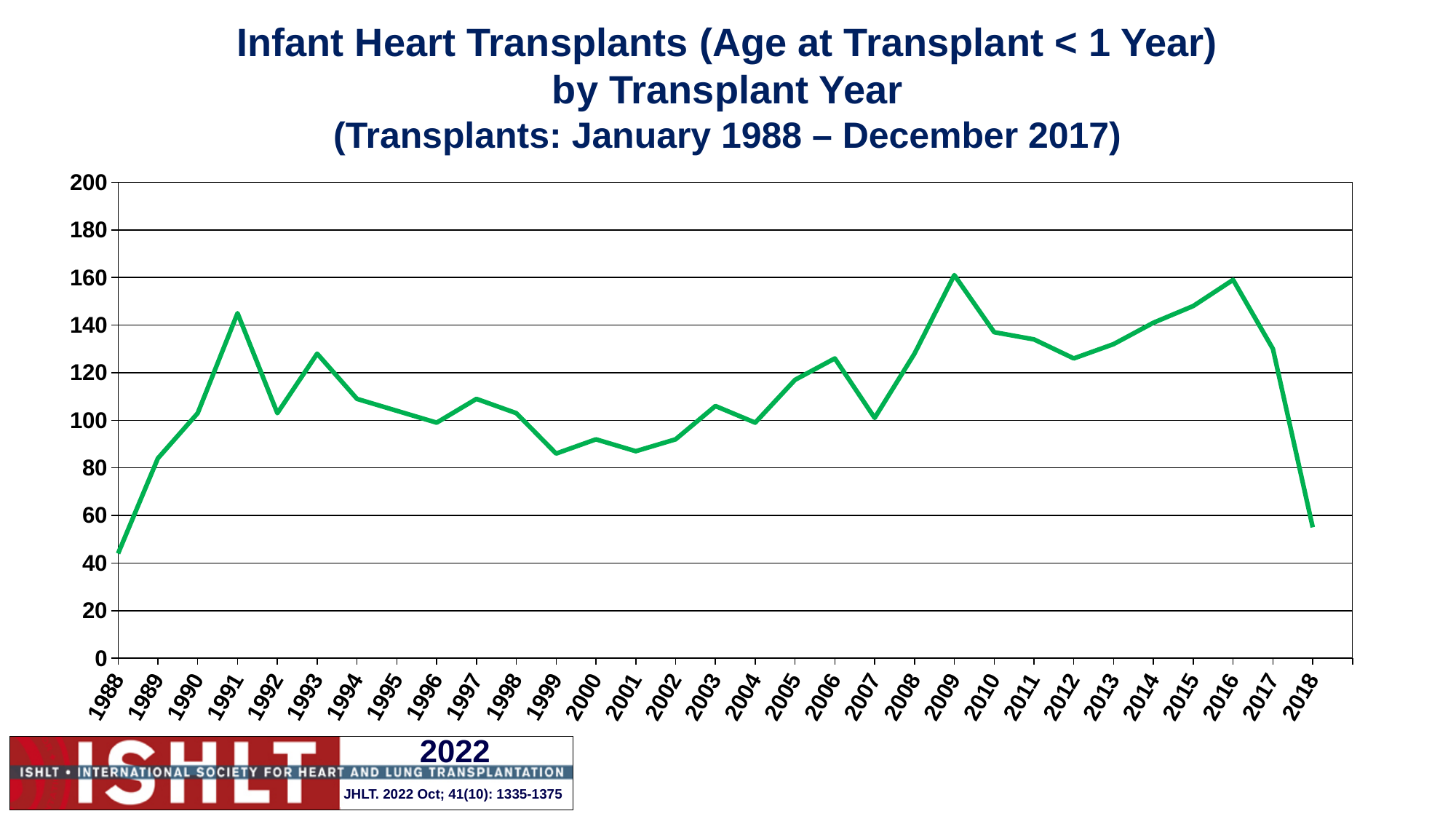
Is the value for 2007 greater or less than 120? less What kind of chart is shown on the slide? line chart What colour is the plotted line? green How many transplant years are plotted along the x axis? 31 Which year has the larger value, 1991 or 1993? 1991 Do the values rise or fall from 2016 to 2018? fall Is the value for 1999 greater or less than 100? less Which year has the larger value, 1988 or 2018? 2018 Is the value for 2009 greater or less than 140? greater Which transplant year has the lowest number of infant heart transplants? 1988 Do the values rise or fall from 1988 to 1991? rise